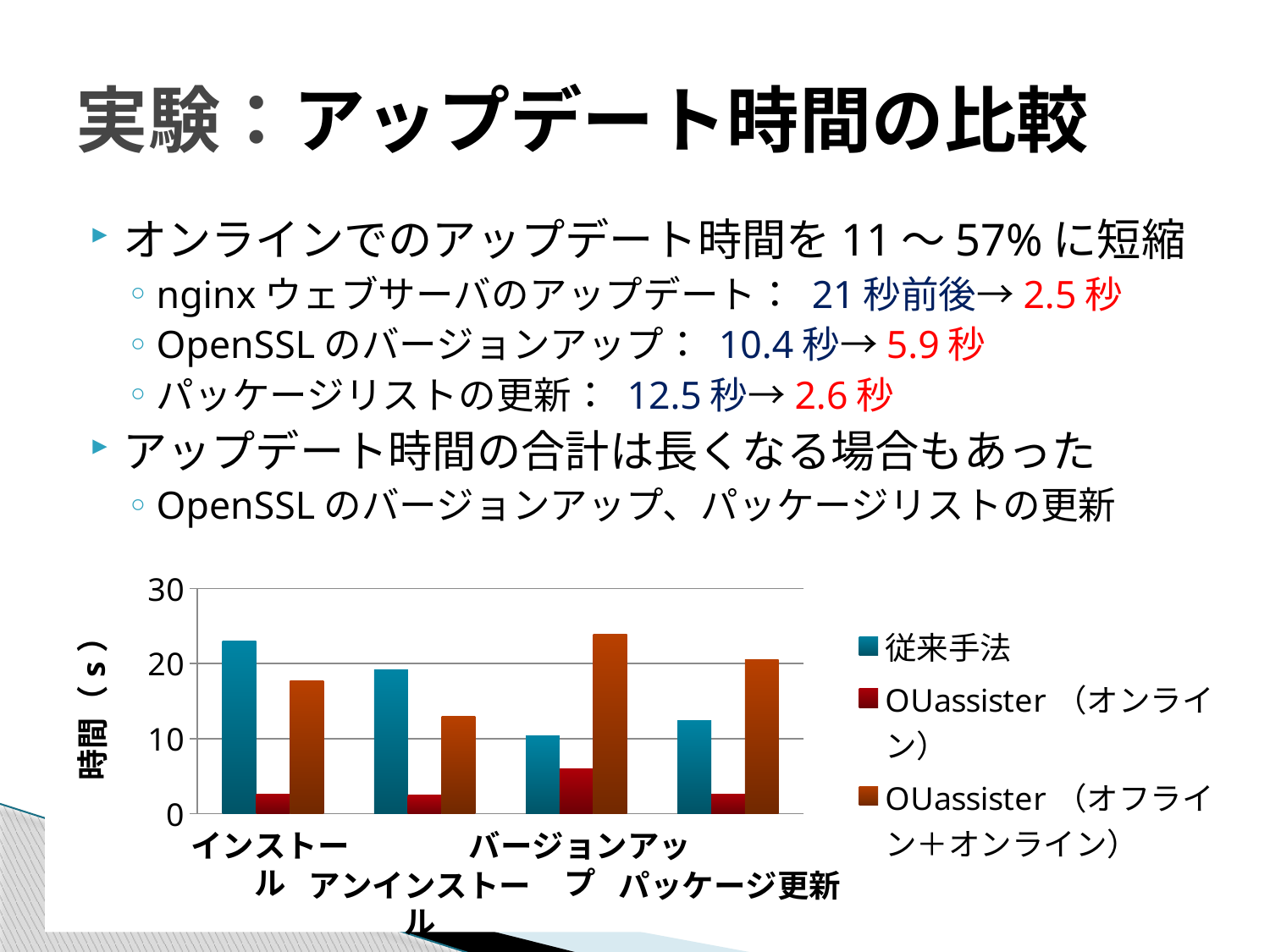
Which series is shown in dark red in the chart? OUassister（オンライン） In the バージョンアップ category, which is larger: 従来手法 or OUassister（オフライン＋オンライン）? OUassister（オフライン＋オンライン） In which category is the OUassister（オンライン） bar the tallest? バージョンアップ Is the value for 従来手法 in the インストール category greater or less than 20? greater What is the label of the vertical axis of the chart? 時間（s） In which category is the 従来手法 bar the tallest? インストール Is the value for OUassister（オフライン＋オンライン） in the バージョンアップ category greater or less than 20? greater How many categories are shown on the x axis of the chart? 4 Is the value for 従来手法 in the アンインストール category greater or less than 10? greater How many series does the chart legend list? 3 What kind of chart is shown on the slide? bar chart